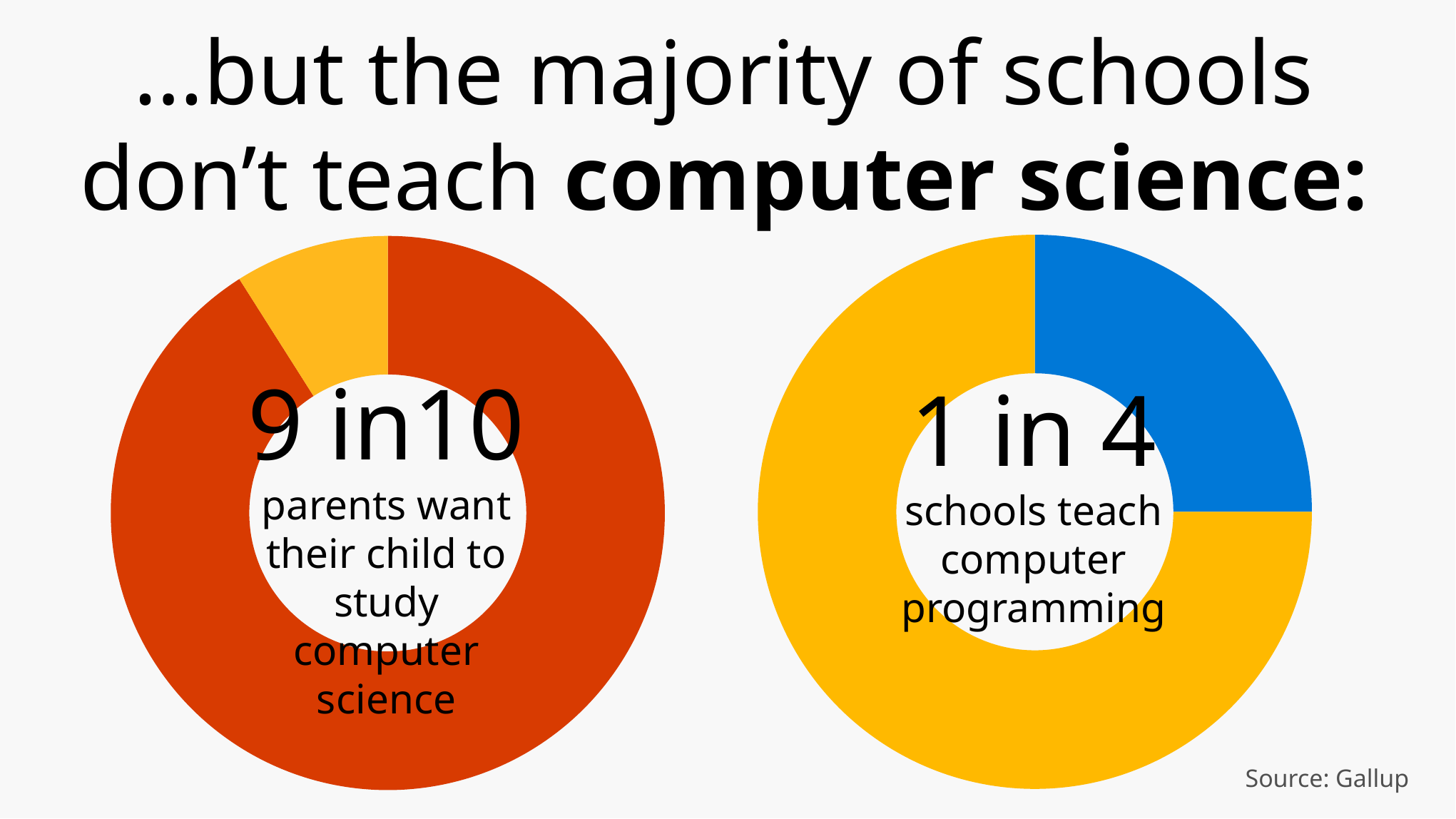
In the right chart, which slice is larger, the blue one or the yellow one? The yellow one How many slices does the left donut chart have? 2 What colour is the slice representing schools that teach computer programming in the right chart? Blue In the right chart, what proportion of schools teach computer programming? 1 in 4 In the left chart, which slice is larger, the red one or the yellow one? The red one In the left chart, is the red slice's share greater or less than 50%? greater How many slices does the right donut chart have? 2 What kind of chart is the left chart on the slide? Donut (pie) chart What kind of chart is the right chart on the slide? Donut (pie) chart In the right chart, is the blue slice's share greater or less than 50%? less In the left chart, what proportion of parents want their child to study computer science? 9 in 10 What source is cited for the charts on the slide? Gallup